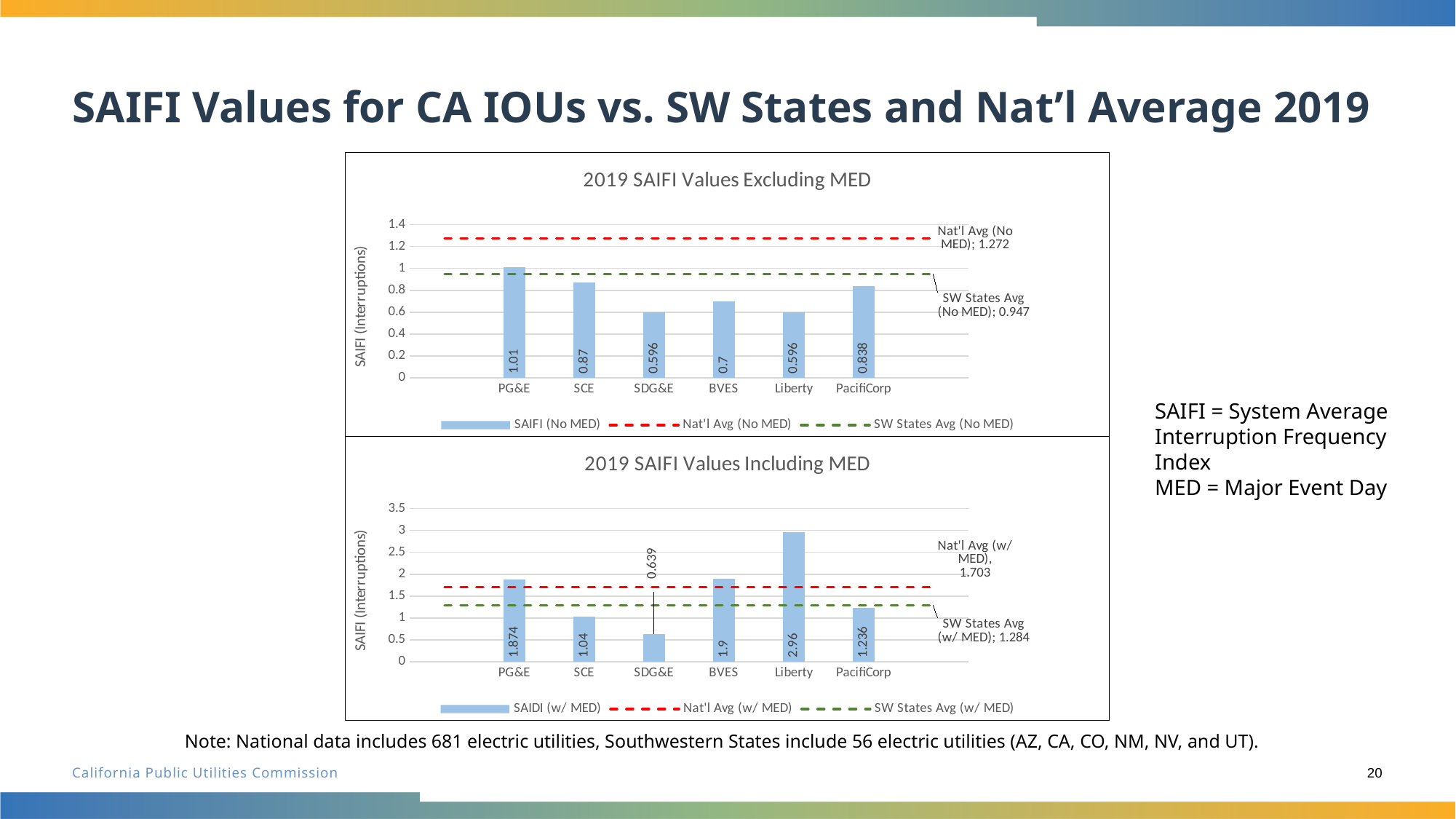
In the '2019 SAIFI Values Excluding MED' chart, which utility has the highest SAIFI value? PG&E In the '2019 SAIFI Values Including MED' chart, what is the SAIFI value for Liberty? 2.96 What type of chart is the '2019 SAIFI Values Excluding MED' chart? Combination bar and line chart (bars with dashed average lines) In the '2019 SAIFI Values Excluding MED' chart, what is the SAIFI value for PG&E? 1.01 How many utilities are shown on the x axis of the '2019 SAIFI Values Including MED' chart? 6 In the '2019 SAIFI Values Including MED' chart, which utility has the lowest SAIFI value? SDG&E In the '2019 SAIFI Values Excluding MED' chart, which is larger: the value for SCE or the value for PacifiCorp? SCE In the '2019 SAIFI Values Including MED' chart, what is the SW States Avg (w/ MED) value shown? 1.284 In the '2019 SAIFI Values Including MED' chart, what is the difference between Liberty's value and SCE's value? 1.92 How many entries does the legend of the '2019 SAIFI Values Excluding MED' chart list? 3 In the '2019 SAIFI Values Excluding MED' chart, what is the Nat'l Avg (No MED) value shown? 1.272 In the '2019 SAIFI Values Including MED' chart, what colour is the dashed line for Nat'l Avg (w/ MED)? Red